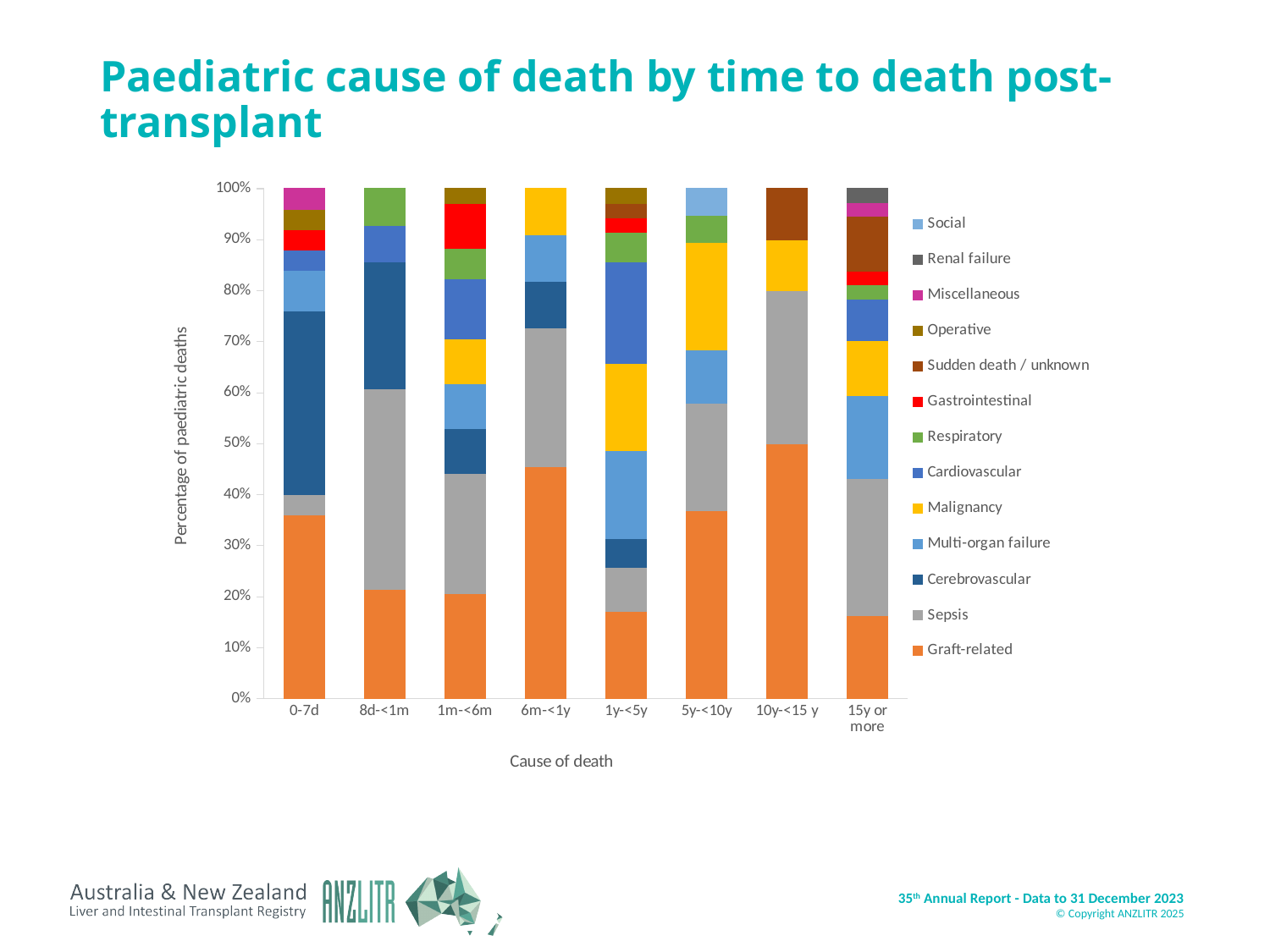
Which time-to-death category has the largest Cerebrovascular share? 0-7d What is the label of the y axis? Percentage of paediatric deaths Which has the larger Graft-related share, 0-7d or 8d-<1m? 0-7d Is the Graft-related share for 1y-<5y greater or less than 20%? less How many time-to-death categories are shown on the x axis? 8 Is the Graft-related share for 0-7d greater or less than 30%? greater Which time-to-death category has the largest Sepsis share? 8d-<1m How many series does the legend list? 13 Is the Graft-related share for 6m-<1y greater or less than 40%? greater What kind of chart is shown on the slide? Stacked bar chart Which time-to-death category has the largest Graft-related share? 10y-<15 y What is the title of the chart? Paediatric cause of death by time to death post-transplant